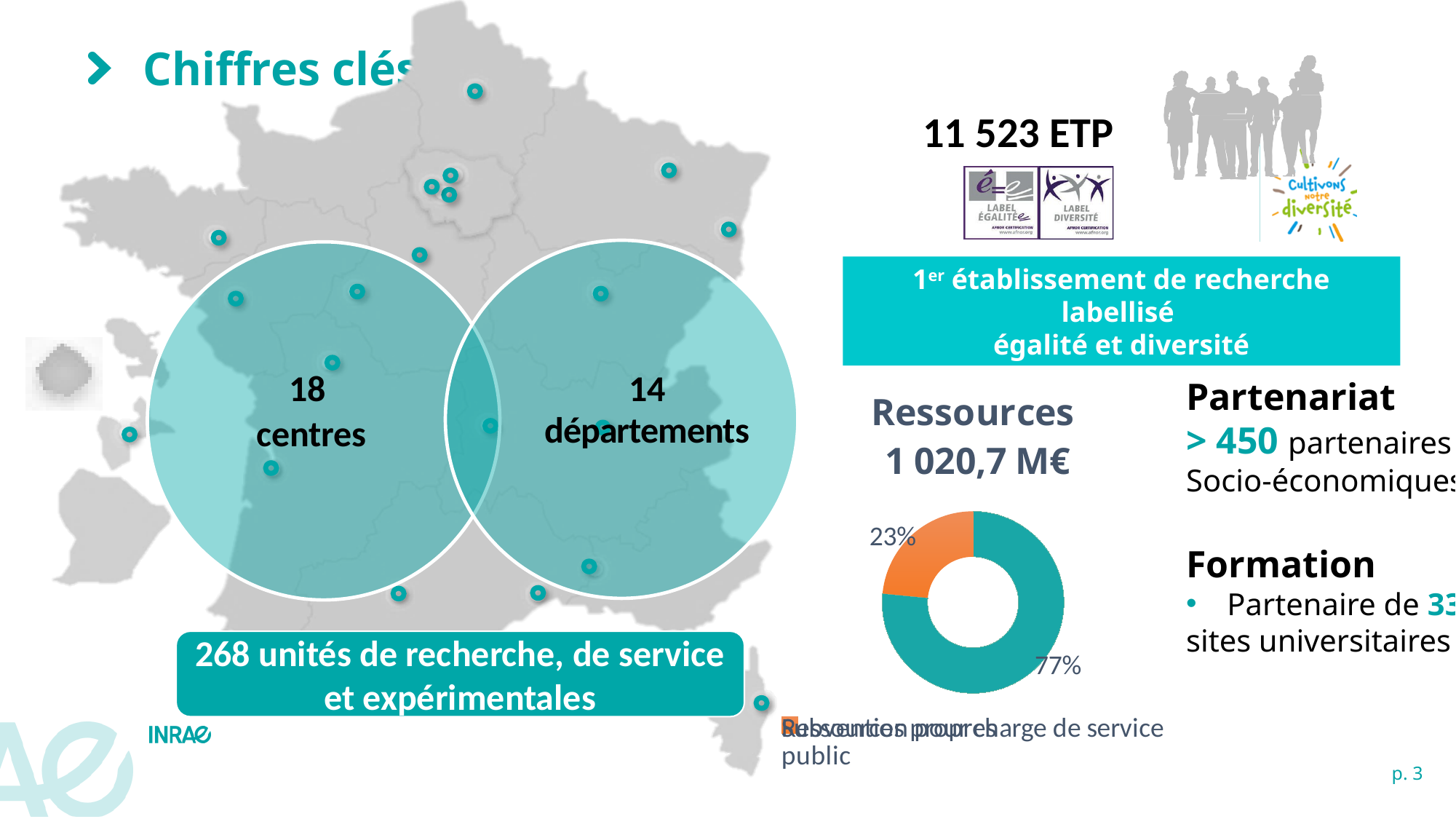
What total amount of resources is stated above the donut chart? 1 020,7 M€ What percentage is shown for the teal slice of the donut chart? 77% How many slices does the donut chart under "Ressources" have? 2 What kind of chart is shown under the heading "Ressources"? pie chart (donut) What is the difference in percentage points between the teal slice and the orange slice of the donut chart? 54 percentage points What is the heading written above the donut chart? Ressources Which slice of the donut chart is the smallest? the orange slice (23%) Which slice of the donut chart is the largest? the teal slice (77%) Is the orange slice of the donut chart larger or smaller than the teal slice? smaller What percentage is shown for the orange slice of the donut chart? 23%